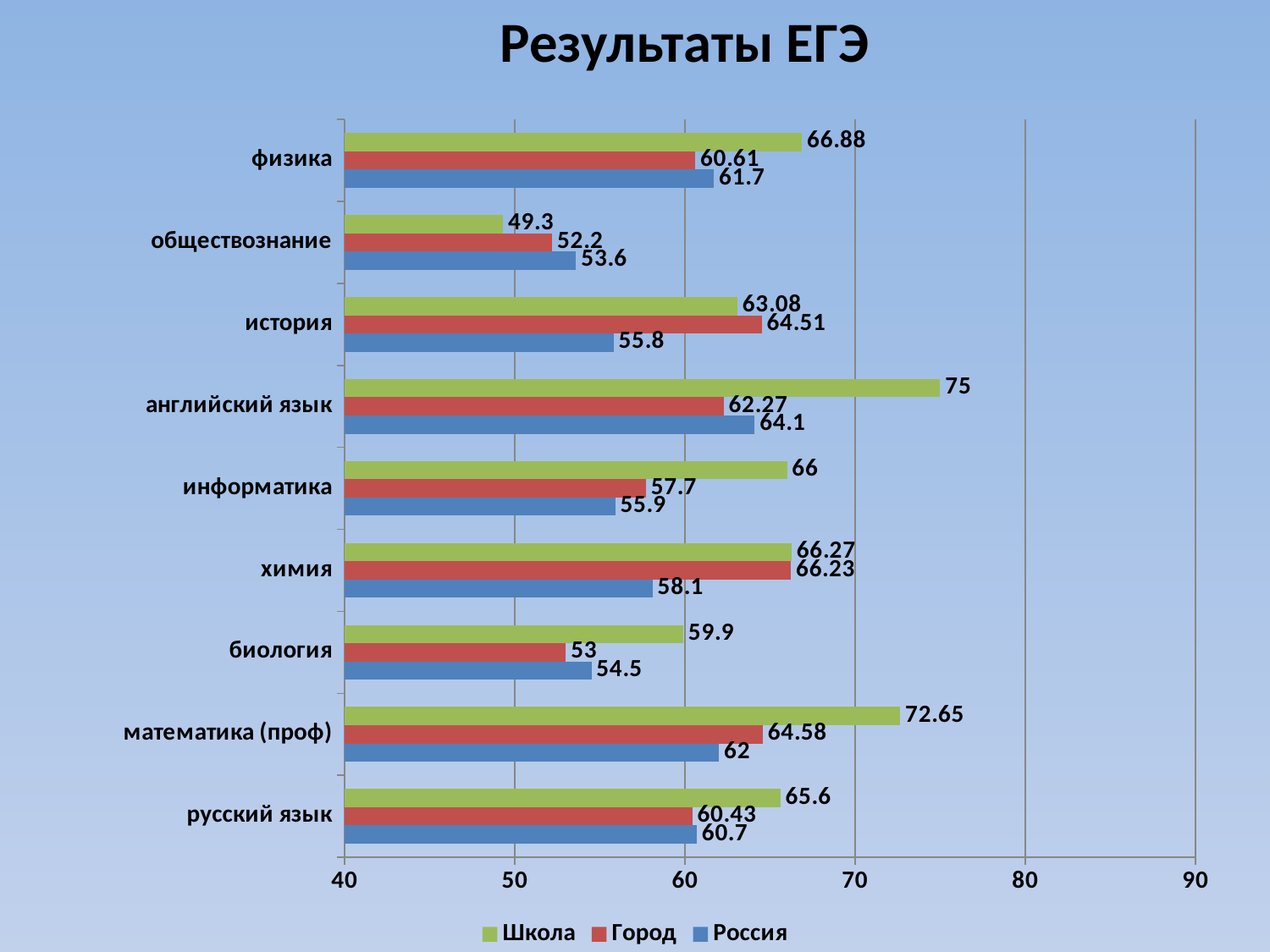
What is the value for Россия in the обществознание category? 53.6 Which category has the lowest value for the Город series? обществознание What is the difference between the Школа and Город values for физика? 6.27 What is the difference between the Школа and Россия values for математика (проф)? 10.65 How many categories (subjects) are shown on the chart? 9 How many series does the legend list? 3 What kind of chart is shown on the slide? Bar chart What is the value for Город in the математика (проф) category? 64.58 Which category has the highest value for the Школа series? английский язык Which category has the lowest value for the Школа series? обществознание Which is larger for история: the Город value or the Россия value? Город What is the value for Школа in the физика category? 66.88